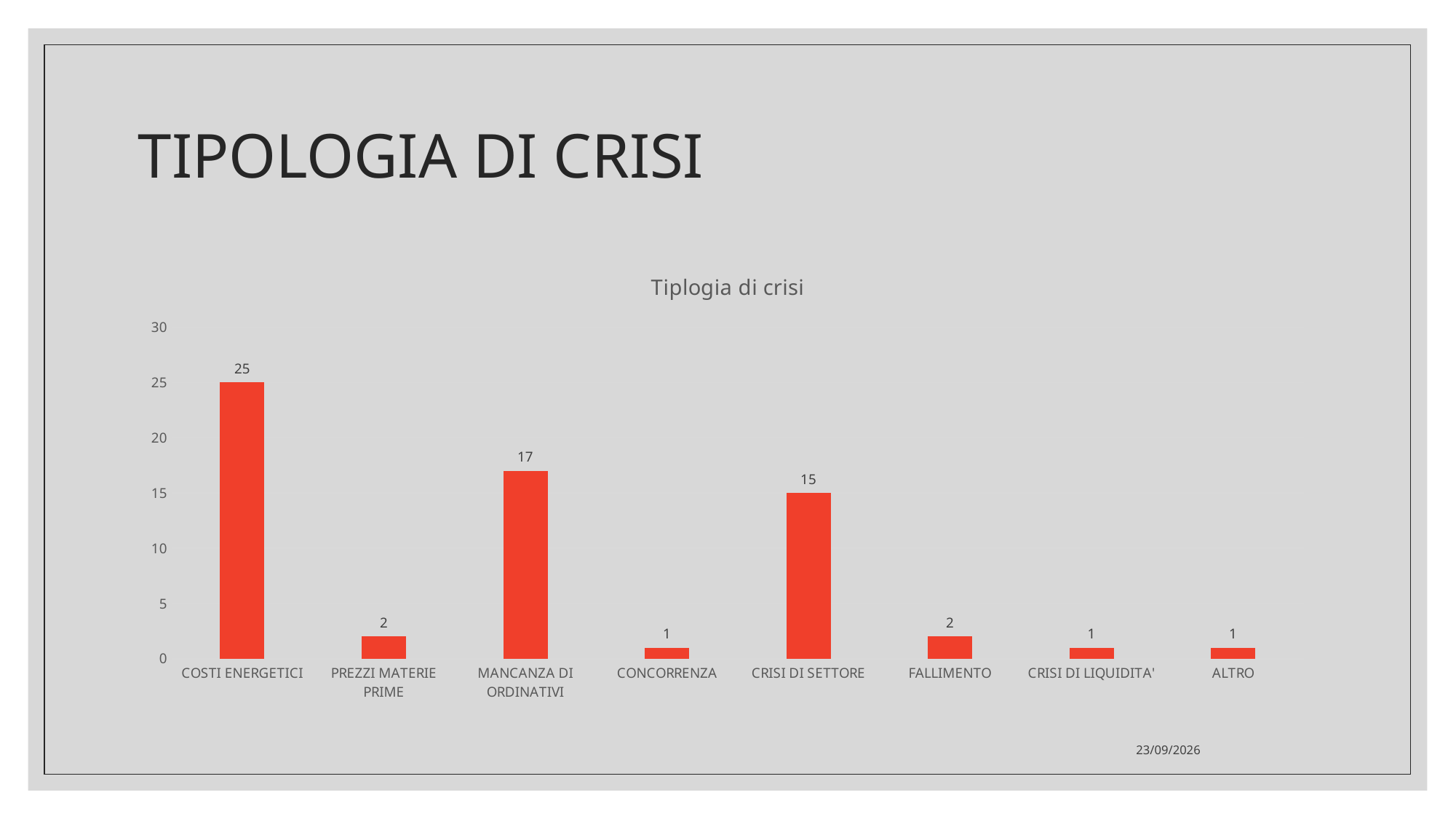
What is the title of the chart? Tiplogia di crisi What is the value for FALLIMENTO? 2 What kind of chart is shown on the slide? bar chart What is the difference between the values for MANCANZA DI ORDINATIVI and CRISI DI SETTORE? 2 What is the value for CRISI DI SETTORE? 15 Is the value for CRISI DI SETTORE greater or less than 10? greater Which category has the highest value? COSTI ENERGETICI How many categories are shown on the x axis? 8 What is the value for MANCANZA DI ORDINATIVI? 17 Which is larger, the value for PREZZI MATERIE PRIME or the value for CONCORRENZA? PREZZI MATERIE PRIME What is the difference between the values for COSTI ENERGETICI and MANCANZA DI ORDINATIVI? 8 What is the value for COSTI ENERGETICI? 25